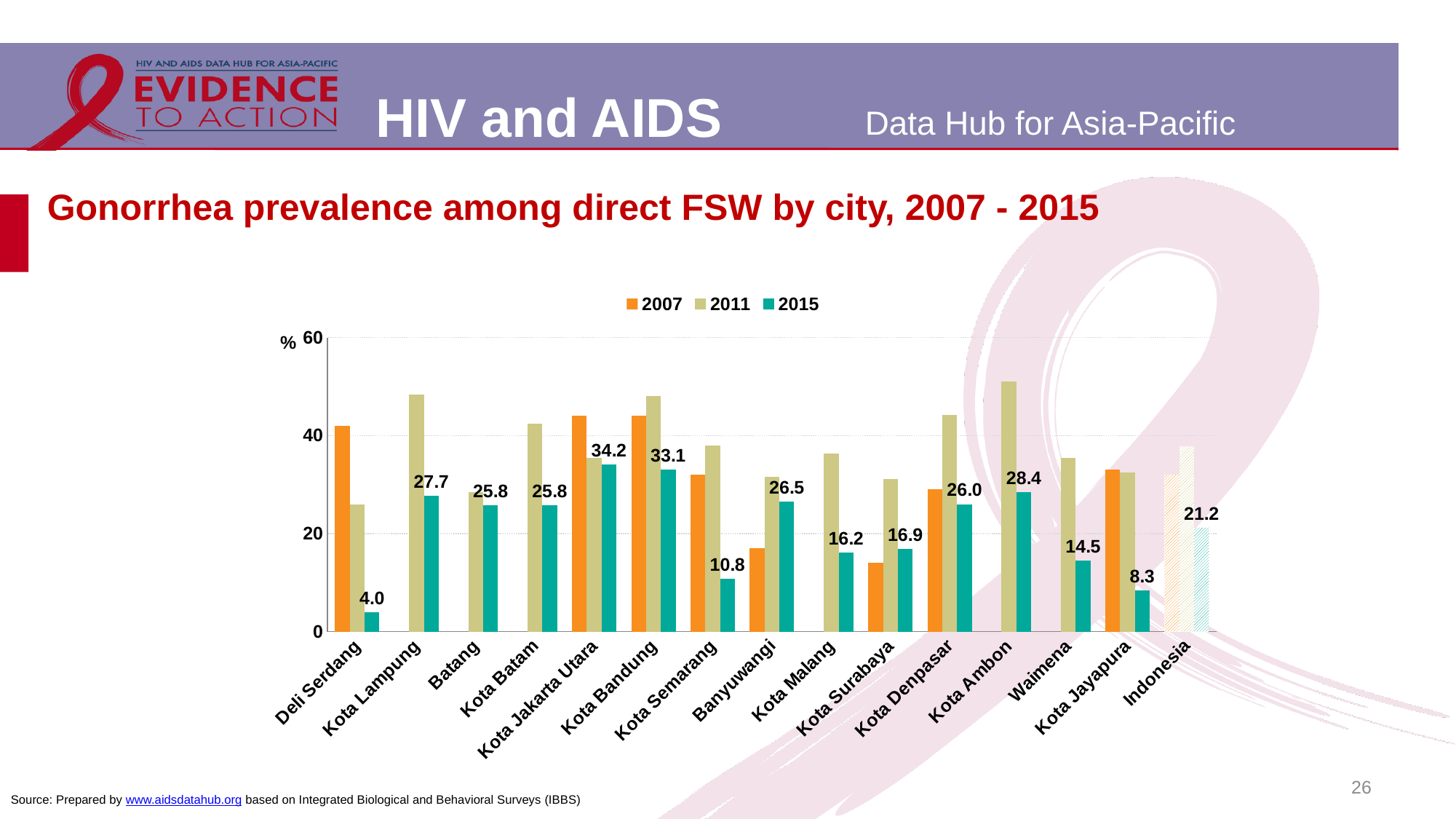
What is the 2015 gonorrhea prevalence value for Kota Jakarta Utara? 34.2 Which city has the highest 2015 value? Kota Jakarta Utara What is the 2015 value for Indonesia? 21.2 How many series does the legend list? 3 What kind of chart is shown on the slide? Bar chart Is the 2011 value for Kota Ambon greater or less than 40? greater What is the difference between the 2015 values for Kota Jakarta Utara and Kota Bandung? 1.1 Is the 2007 value for Kota Surabaya greater or less than 20? less What is the 2015 value for Deli Serdang? 4.0 How many cities/categories are shown on the x axis? 15 Which city has the lowest 2015 value? Deli Serdang Which has the larger 2015 value, Kota Ambon or Kota Lampung? Kota Ambon